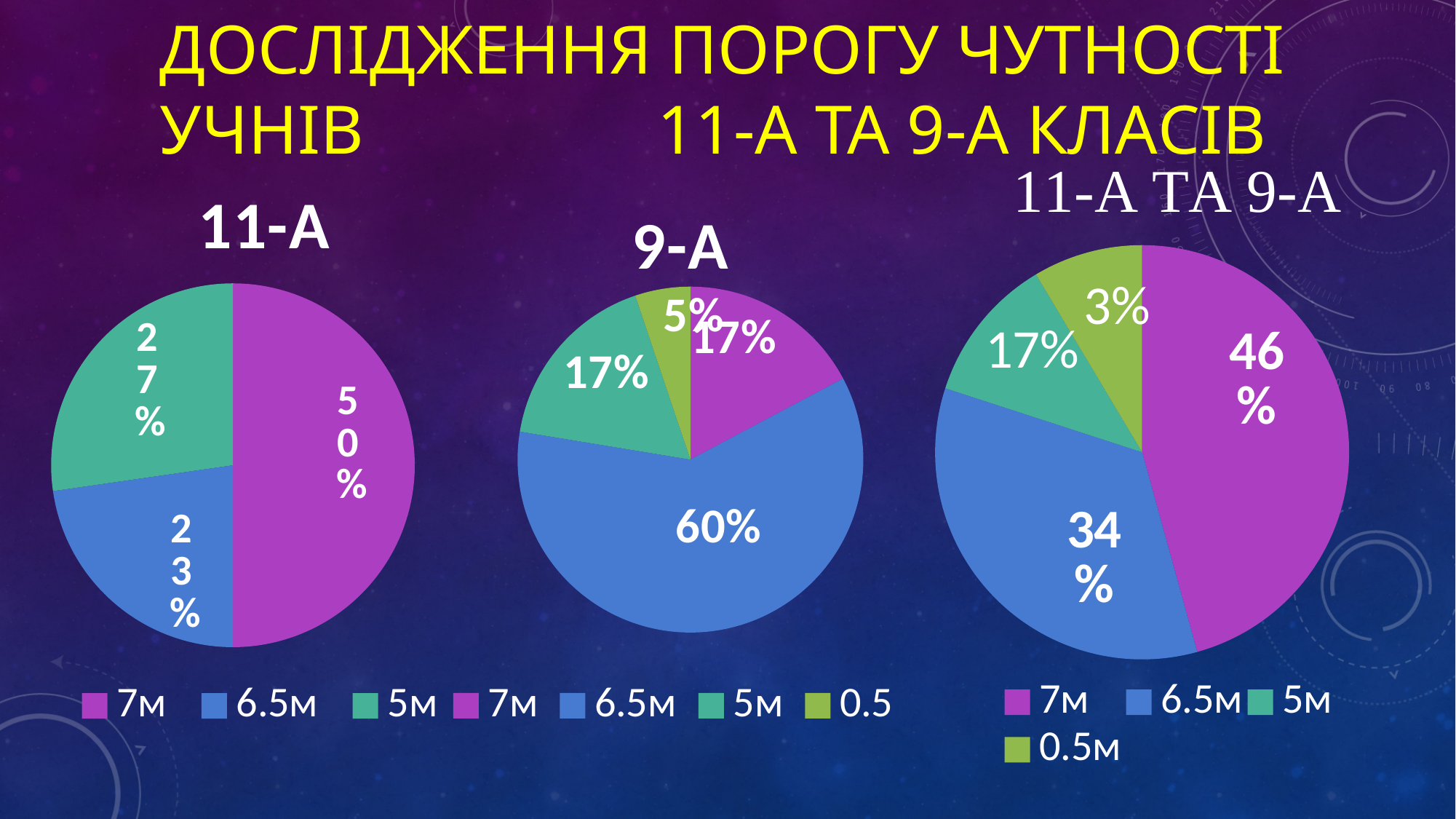
In the "9-A" pie chart, how many slices are there? 4 In the "11-A" pie chart, which category has the smallest share? 6.5м In the "11-А ТА 9-А" pie chart, what is the difference between the 7м share and the 6.5м share? 12% In the "9-A" pie chart, what share does the 6.5м slice have? 60% In the "9-A" pie chart, what share does the 0.5 slice have? 5% In the "11-A" pie chart, what share does the 7м slice have? 50% In the "11-A" pie chart, what share does the 5м slice have? 27% In the "9-A" pie chart, which category has the largest share? 6.5м In the "11-А ТА 9-А" pie chart, which is larger, the 5м share or the 0.5м share? 5м In the "11-А ТА 9-А" pie chart, what share does the 7м slice have? 46% How many entries does the legend of the "11-А ТА 9-А" chart list? 4 What type of chart is used for "11-A"? Pie chart